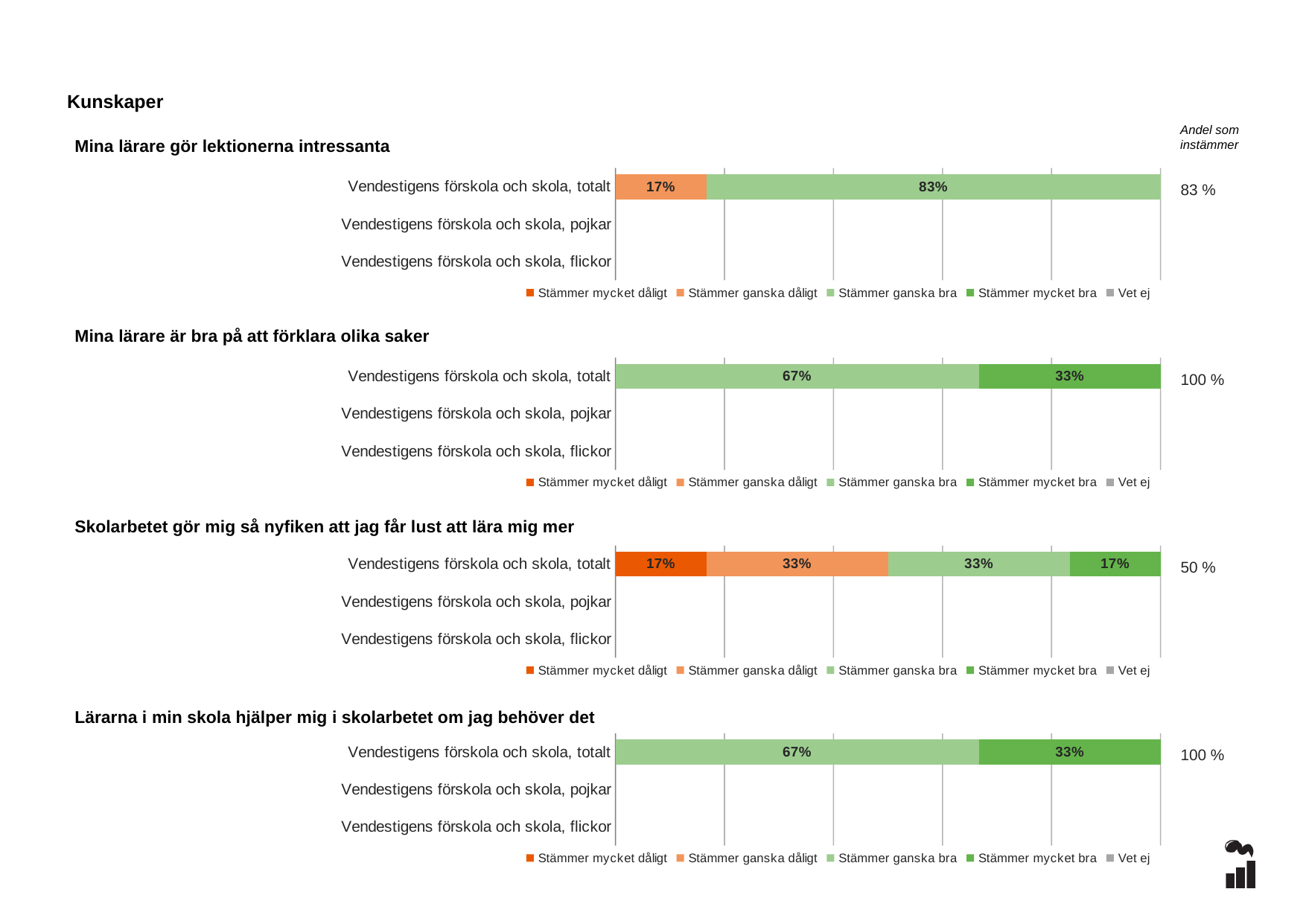
How many categories are shown on the y axis of the chart 'Lärarna i min skola hjälper mig i skolarbetet om jag behöver det'? 3 How many series does the legend list in the chart 'Mina lärare är bra på att förklara olika saker'? 5 In the chart 'Skolarbetet gör mig så nyfiken att jag får lust att lära mig mer', what is the value for 'Stämmer mycket dåligt' for Vendestigens förskola och skola, totalt? 17% In the chart 'Mina lärare är bra på att förklara olika saker', what is the value for 'Stämmer mycket bra' for Vendestigens förskola och skola, totalt? 33% In the chart 'Mina lärare gör lektionerna intressanta', which is larger for Vendestigens förskola och skola, totalt: 'Stämmer ganska dåligt' or 'Stämmer ganska bra'? Stämmer ganska bra In the chart 'Lärarna i min skola hjälper mig i skolarbetet om jag behöver det', what is the difference between 'Stämmer ganska bra' and 'Stämmer mycket bra' for Vendestigens förskola och skola, totalt? 34% What is the 'Andel som instämmer' shown for Vendestigens förskola och skola, totalt in the chart 'Mina lärare är bra på att förklara olika saker'? 100 % In the chart 'Mina lärare gör lektionerna intressanta', what is the value for 'Stämmer ganska bra' for Vendestigens förskola och skola, totalt? 83% In the chart 'Skolarbetet gör mig så nyfiken att jag får lust att lära mig mer', what is the 'Andel som instämmer' shown for Vendestigens förskola och skola, totalt? 50 % In the chart 'Skolarbetet gör mig så nyfiken att jag får lust att lära mig mer', what is the total of the stacked bar for Vendestigens förskola och skola, totalt? 100% What kind of chart is 'Mina lärare gör lektionerna intressanta'? Stacked bar chart In the chart 'Mina lärare gör lektionerna intressanta', what is the value for 'Stämmer ganska dåligt' for Vendestigens förskola och skola, totalt? 17%